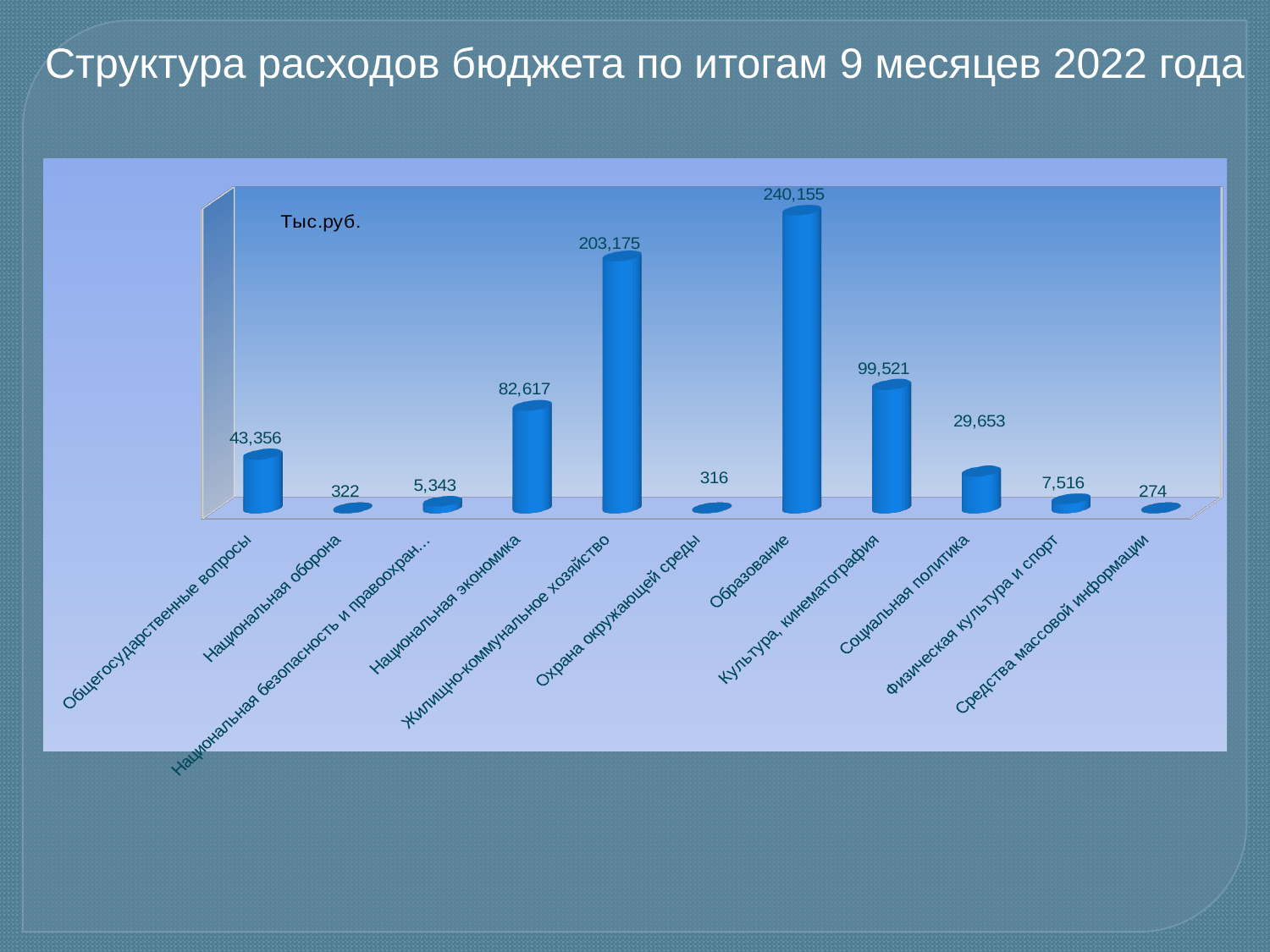
What is the value for Жилищно-коммунальное хозяйство? 203,175 What is the difference between the values for Образование and Жилищно-коммунальное хозяйство? 36,980 What is the value for Социальная политика? 29,653 What is the value for Образование? 240,155 What is the difference between the values for Культура, кинематография and Национальная экономика? 16,904 How many categories are shown in the chart? 11 What unit is indicated on the chart? Тыс.руб. What kind of chart is shown on the slide? Bar chart What is the value for Национальная оборона? 322 Which category has the lowest value? Средства массовой информации Which category has the highest value? Образование Which is larger, the value for Общегосударственные вопросы or the value for Социальная политика? Общегосударственные вопросы